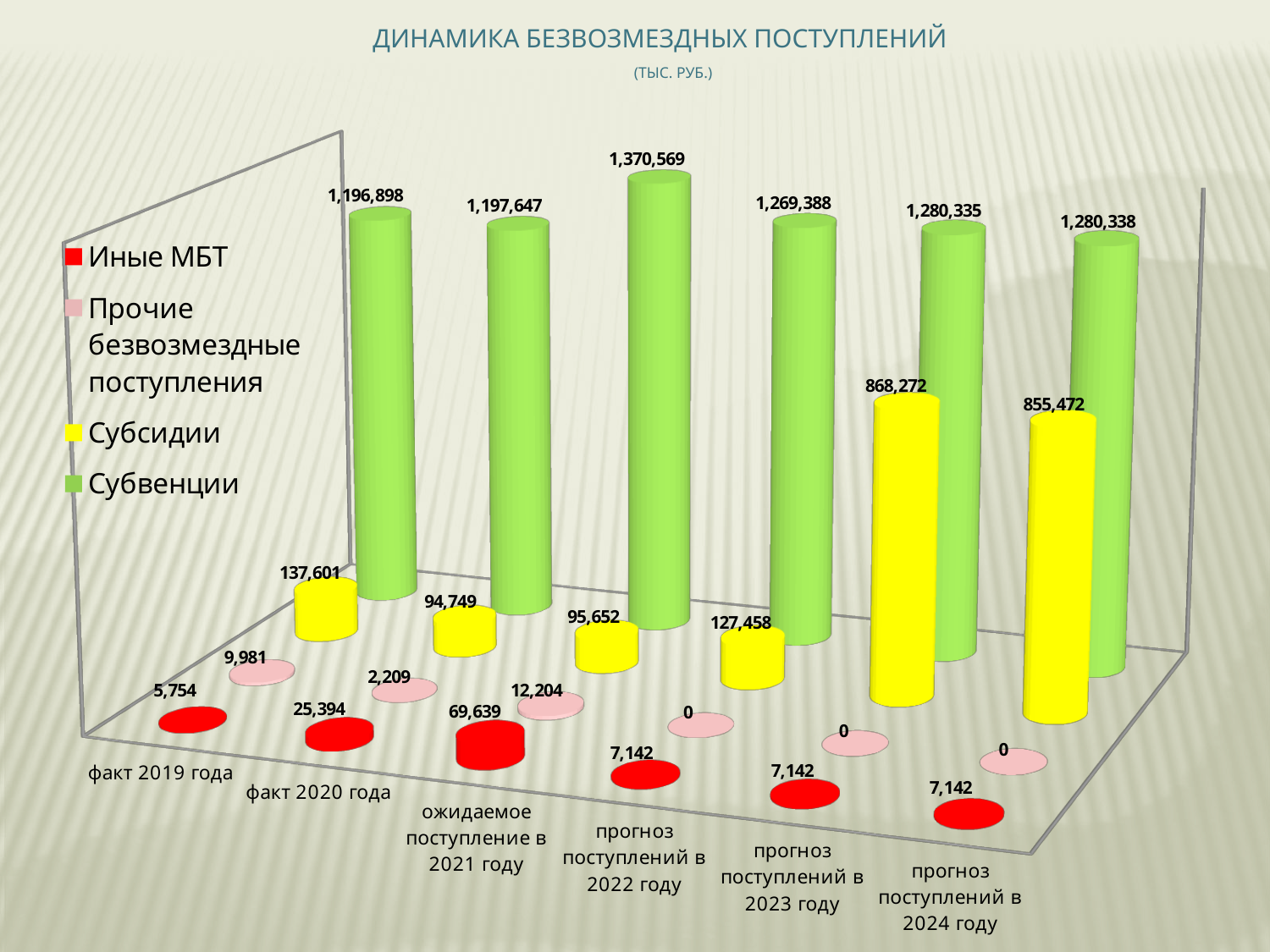
What unit is stated under the chart title? тыс. руб. In which category is the value of Субвенции the highest? ожидаемое поступление в 2021 году What is the value of Прочие безвозмездные поступления for факт 2019 года? 9,981 How many series does the legend list? 4 What is the value of Субвенции for ожидаемое поступление в 2021 году? 1,370,569 What is the difference between the Субсидии values for прогноз поступлений в 2023 году and прогноз поступлений в 2022 году? 740,814 How many categories are shown along the x axis? 6 In which category is the value of Субсидии the lowest? факт 2020 года What is the value of Иные МБТ for факт 2020 года? 25,394 What is the value of Субсидии for прогноз поступлений в 2023 году? 868,272 What type of chart is shown on the slide? bar chart Which is larger: Иные МБТ for ожидаемое поступление в 2021 году or for факт 2020 года? ожидаемое поступление в 2021 году